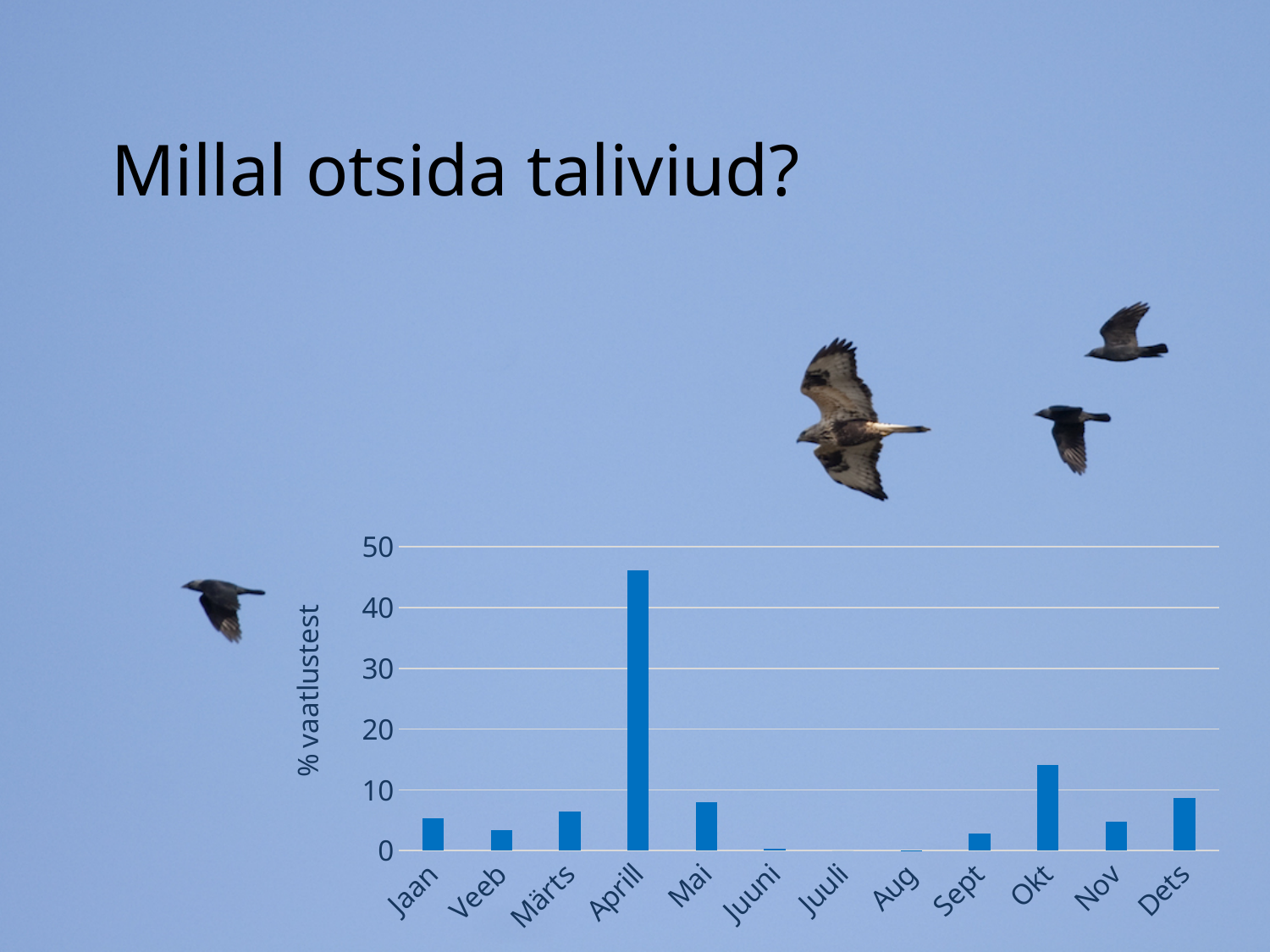
How many months (categories) are shown on the x axis of the chart? 12 Which is larger, the value for Sept or the value for Dets? Dets Is the value for Aprill greater or less than 50? less Is the value for Okt greater or less than 10? greater What kind of chart is shown on the slide? bar chart Is the value for Jaan greater or less than 10? less Which month has the highest value in the chart? Aprill Which is larger, the value for Okt or the value for Mai? Okt Which is larger, the value for Aprill or the value for Okt? Aprill What is the label of the vertical axis of the chart? % vaatlustest